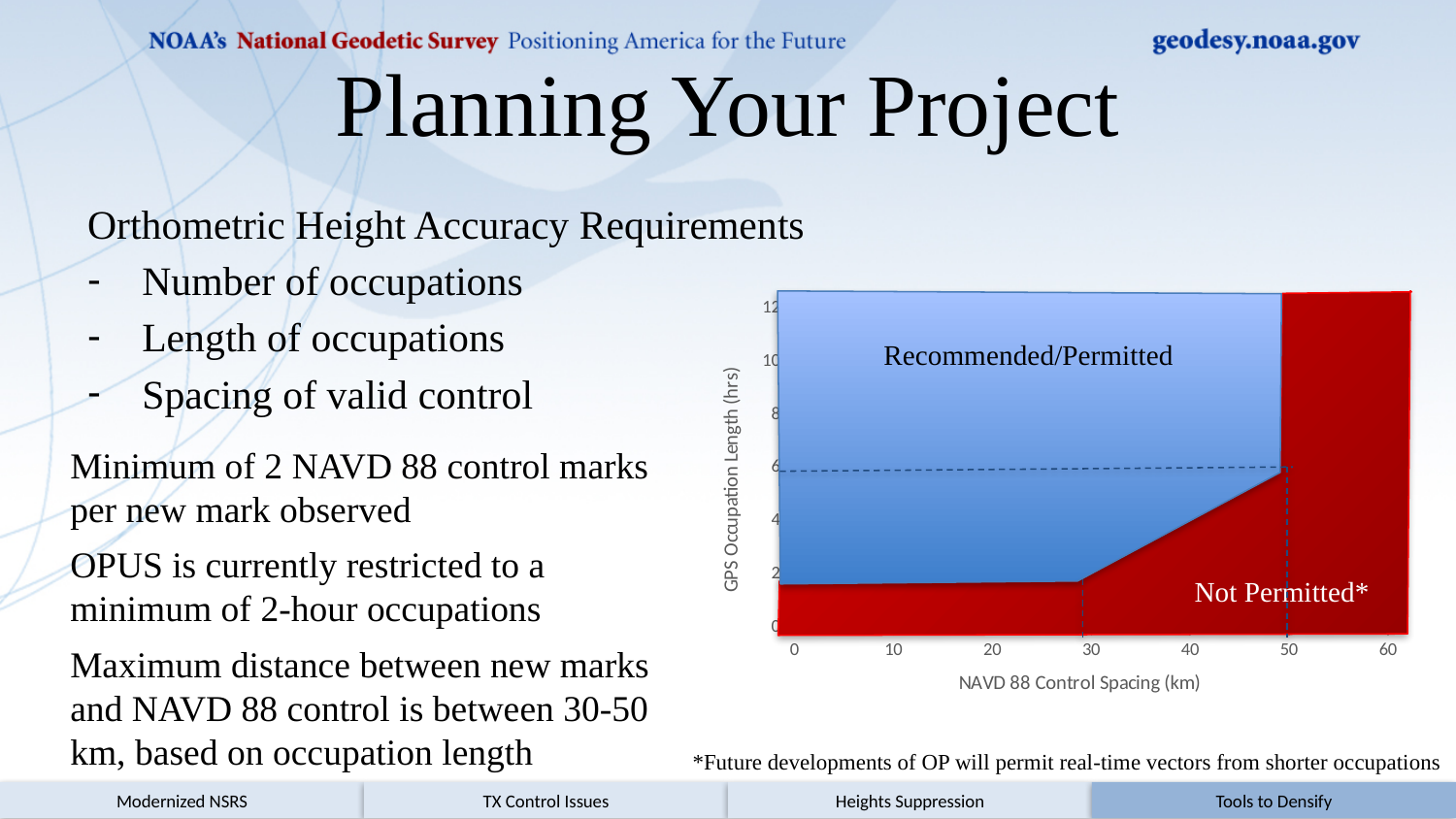
What is the highest value shown on the y axis of the chart? 12 According to the chart, what is the minimum GPS occupation length at a NAVD 88 control spacing of 50 km? 6 hrs What is the label of the y axis of the chart? GPS Occupation Length (hrs) What is the blue region of the chart labelled? Recommended/Permitted Which requires a longer minimum occupation: a control spacing of 30 km or 50 km? 50 km Is the minimum occupation length at 40 km spacing greater or less than 2 hrs? greater Between 30 km and 50 km of control spacing, does the boundary of the permitted region rise or fall? rise What is the label of the x axis of the chart? NAVD 88 Control Spacing (km) According to the chart, what is the minimum GPS occupation length at a NAVD 88 control spacing of 30 km? 2 hrs What is the red region of the chart labelled? Not Permitted* Is the minimum occupation length at 40 km spacing greater or less than 6 hrs? less What kind of chart is shown on the slide? area chart